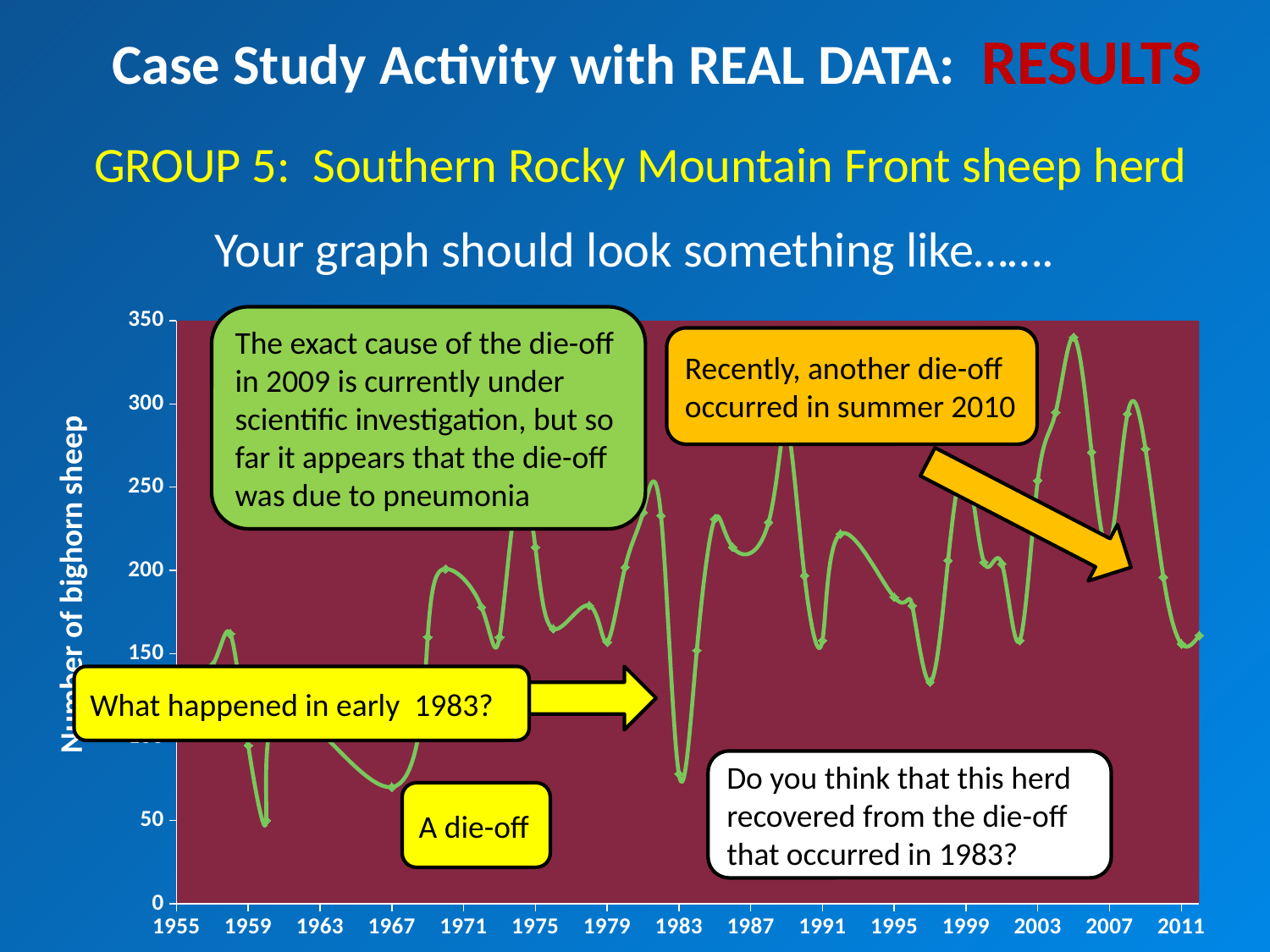
Is the number of bighorn sheep in 2011 greater or less than 200? less What is the last year labelled on the horizontal axis of the chart? 2011 What is the highest value shown on the vertical axis of the chart? 350 What kind of chart is shown on the slide? line chart Does the number of bighorn sheep rise or fall between 2005 and 2007? fall Does the number of bighorn sheep rise or fall between 1983 and 1985? rise Is the number of bighorn sheep in 1989 greater or less than 250? greater Is the number of bighorn sheep in 2005 greater or less than 300? greater What is the first year labelled on the horizontal axis of the chart? 1955 What is the title of the vertical axis of the chart? Number of bighorn sheep